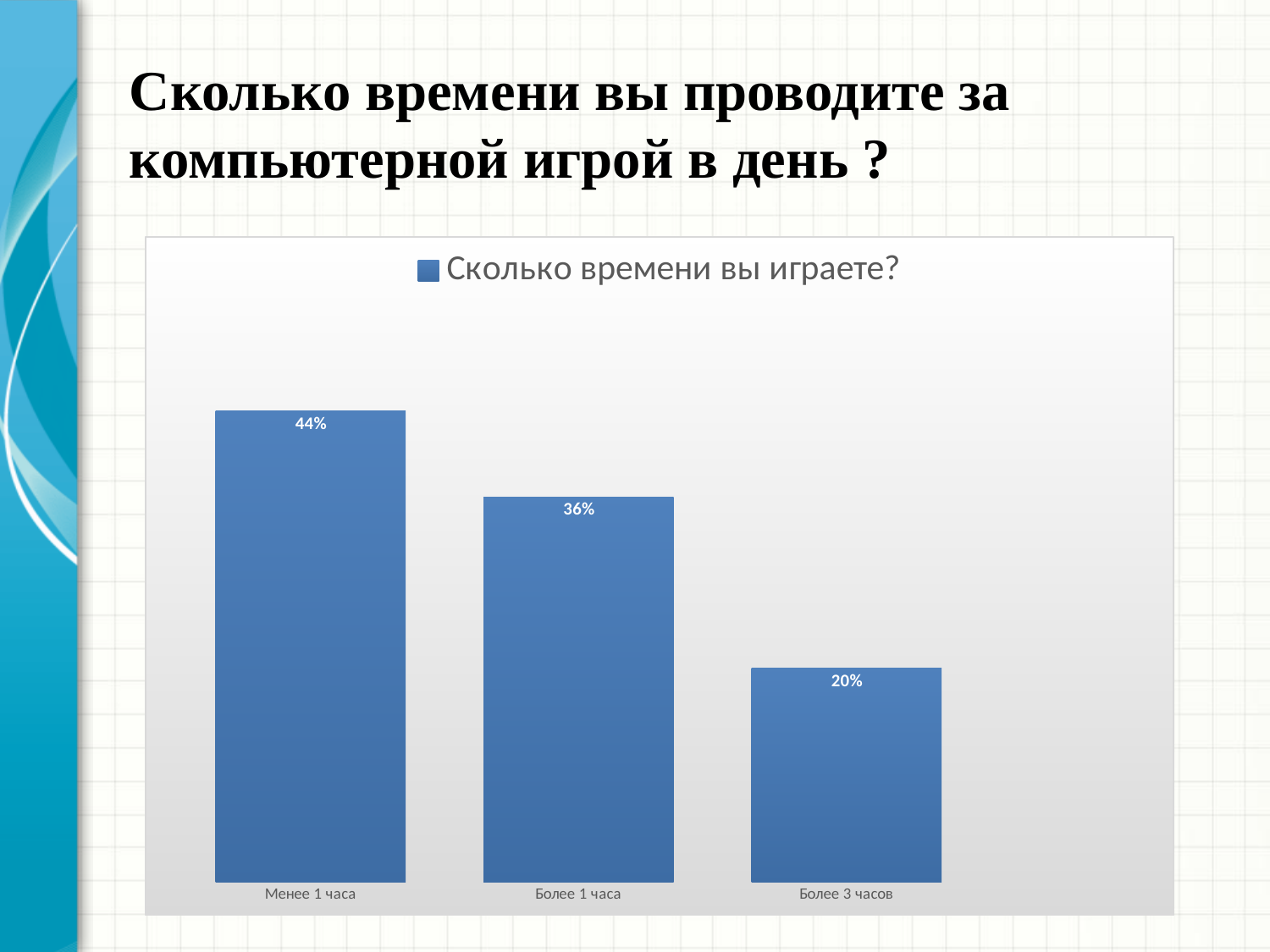
Which is larger, the value for "Более 1 часа" or the value for "Более 3 часов"? Более 1 часа How many series does the legend list? 1 What kind of chart is shown on the slide? bar chart What is the value for "Менее 1 часа"? 44% Do the values rise or fall from left to right along the x axis? fall Which category has the lowest value? Более 3 часов How many categories are shown on the x axis? 3 What is the difference between the values for "Менее 1 часа" and "Более 1 часа"? 8% Which category has the highest value? Менее 1 часа What is the value for "Более 1 часа"? 36% What is the difference between the values for "Менее 1 часа" and "Более 3 часов"? 24% What is the value for "Более 3 часов"? 20%